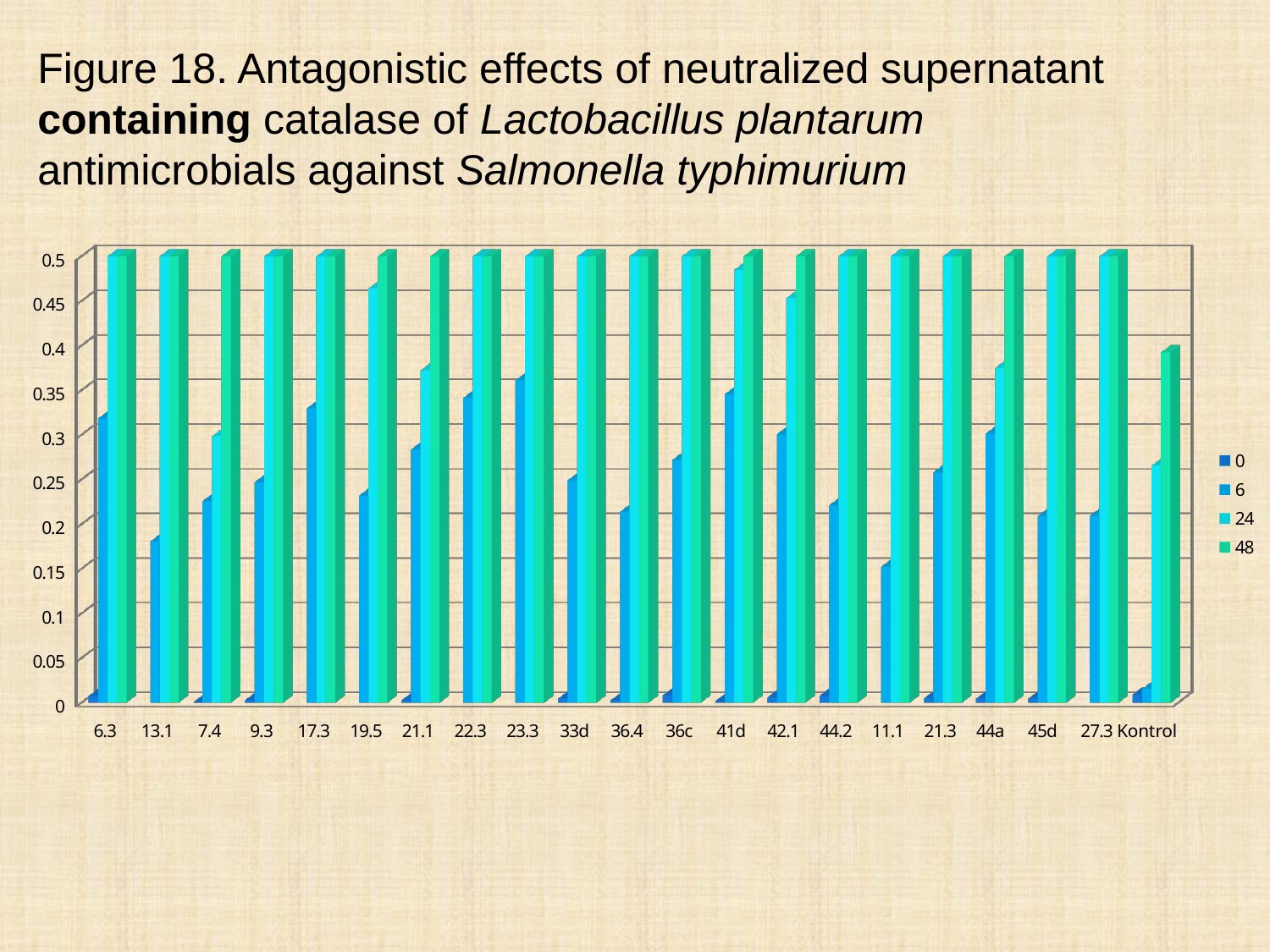
Which category has the lowest value for series 6? Kontrol Is the value of series 6 for category 11.1 greater or less than 0.2? less For series 6, which is larger: the value for 6.3 or the value for 13.1? 6.3 Is the value of series 6 for category 13.1 greater or less than 0.2? less What are the series names listed in the legend? 0, 6, 24, 48 How many categories are shown along the x axis? 21 Is the value of series 24 for category 44a greater or less than 0.35? greater Which category has the lowest value for series 48? Kontrol What is the label of the last category on the x axis? Kontrol How many series does the legend list? 4 What kind of chart is shown on the slide? bar chart